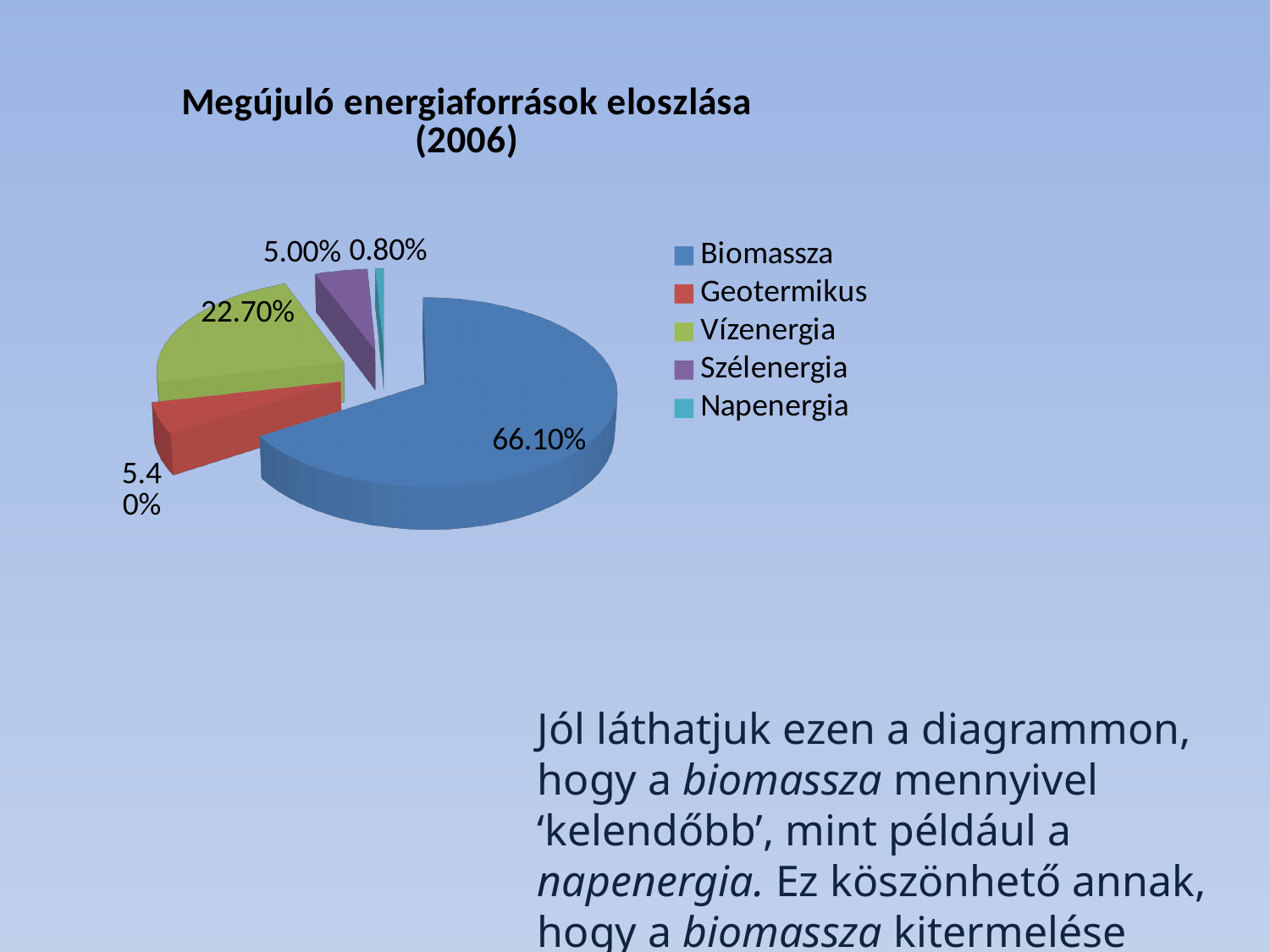
What share of the pie does Biomassza have? 66.10% What share of the pie does Napenergia have? 0.80% What is the title of the chart? Megújuló energiaforrások eloszlása (2006) What share of the pie does Geotermikus have? 5.40% What type of chart is shown on the slide? pie chart Which category has the smallest slice of the pie? Napenergia Which is larger, the share for Vízenergia or the share for Szélenergia? Vízenergia How many categories does the legend list? 5 What share of the pie does Szélenergia have? 5.00% What share of the pie does Vízenergia have? 22.70% Which category has the largest slice of the pie? Biomassza What is the difference in percentage points between Biomassza and Vízenergia? 43.40%